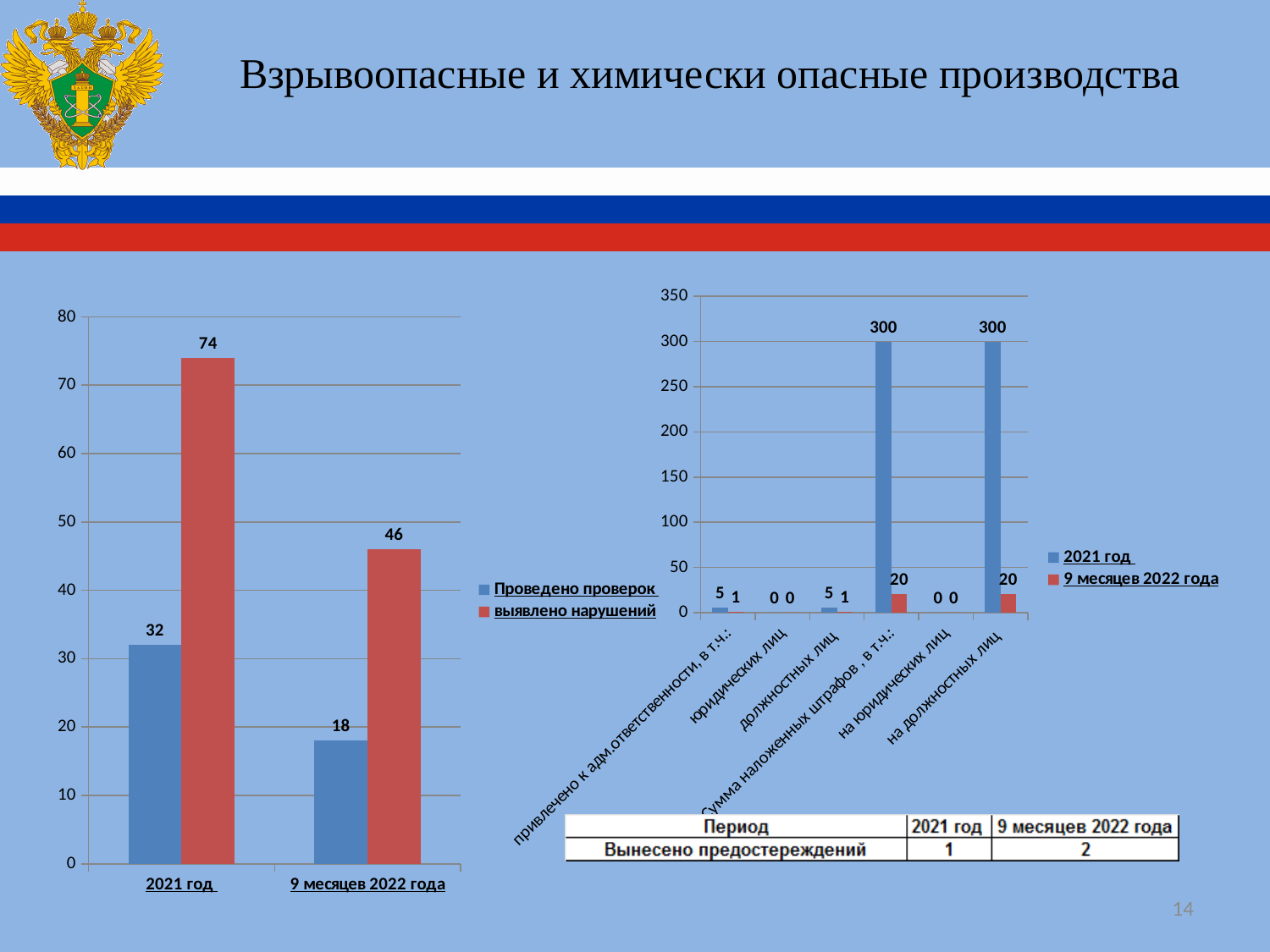
In the left chart, does the value of 'Проведено проверок' rise or fall from '2021 год' to '9 месяцев 2022 года'? fall In the left chart, what is the value of 'выявлено нарушений' for '9 месяцев 2022 года'? 46 In the right chart, what is the value for '9 месяцев 2022 года' in the category 'на должностных лиц'? 20 In the left chart, how many series does the legend list? 2 In the left chart, which series has the higher value for '2021 год': 'Проведено проверок' or 'выявлено нарушений'? выявлено нарушений In the right chart, what is the difference between the '2021 год' and '9 месяцев 2022 года' values for 'на должностных лиц'? 280 In the left chart, what is the value of 'Проведено проверок' for '2021 год'? 32 In the right chart, what is the value for '2021 год' in the category 'должностных лиц'? 5 What kind of chart is the chart on the right of the slide? bar chart In the right chart, how many categories are shown on the x axis? 6 In the left chart, what is the difference between 'выявлено нарушений' in '2021 год' and in '9 месяцев 2022 года'? 28 In the right chart, what is the value for '2021 год' in the category 'Сумма наложенных штрафов, в т.ч.:'? 300